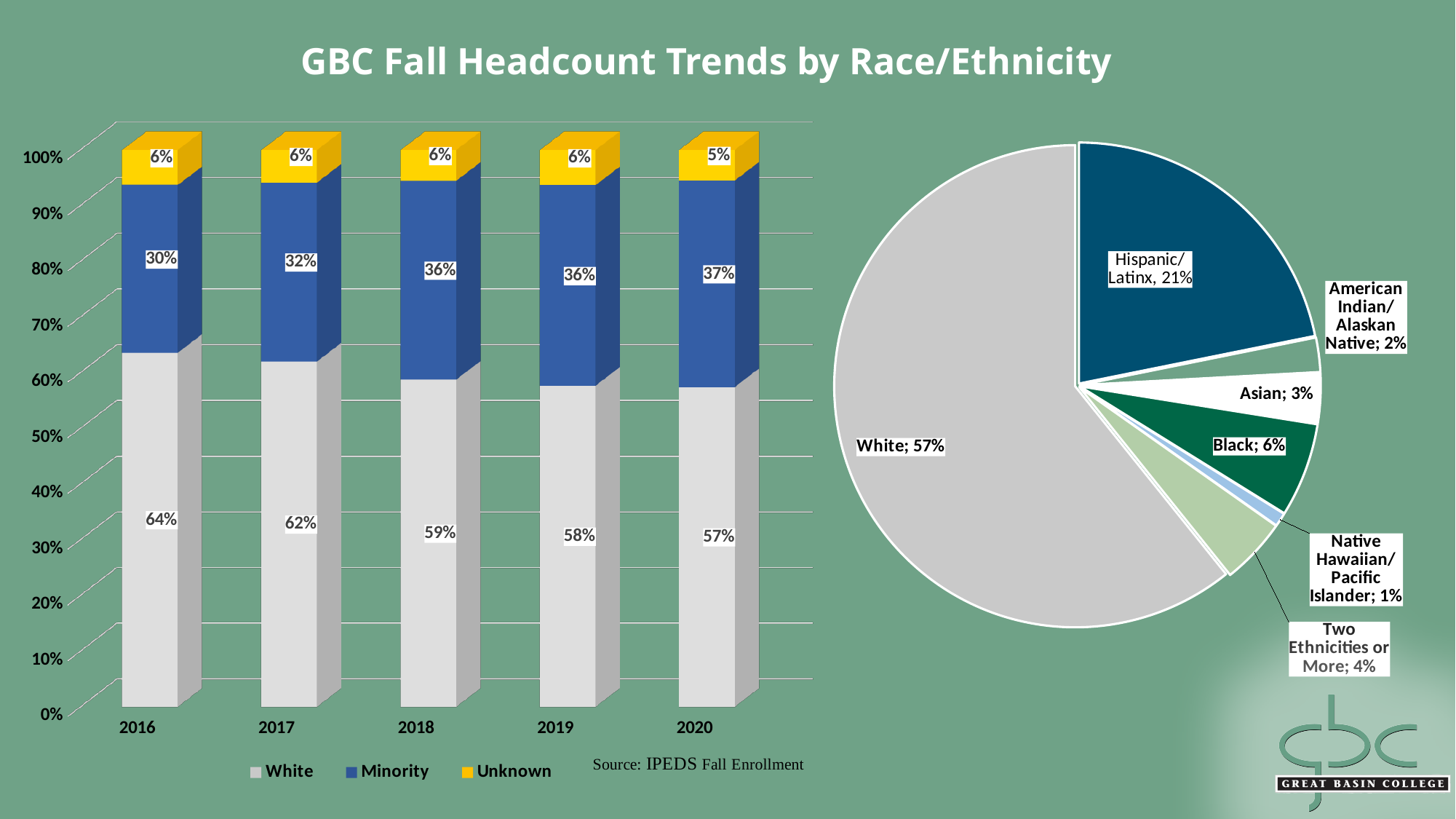
In the stacked bar chart on the left, does the White share rise or fall from 2016 to 2020? fall In the stacked bar chart on the left, how many series does the legend list? 3 In the pie chart on the right, is the Black share larger or smaller than the Asian share? larger In the stacked bar chart on the left, how many years are shown on the x axis? 5 In the stacked bar chart on the left, which year has the lowest White share? 2020 In the stacked bar chart on the left, what is the White share in 2016? 64% In the stacked bar chart on the left, what is the Unknown share in 2020? 5% In the stacked bar chart on the left, which year has the highest Minority share? 2020 In the pie chart on the right, what share is Hispanic/Latinx? 21% In the stacked bar chart on the left, what is the Minority share in 2020? 37% In the stacked bar chart on the left, what is the difference between the White share in 2016 and in 2020? 7% In the pie chart on the right, which slice is the smallest? Native Hawaiian/Pacific Islander